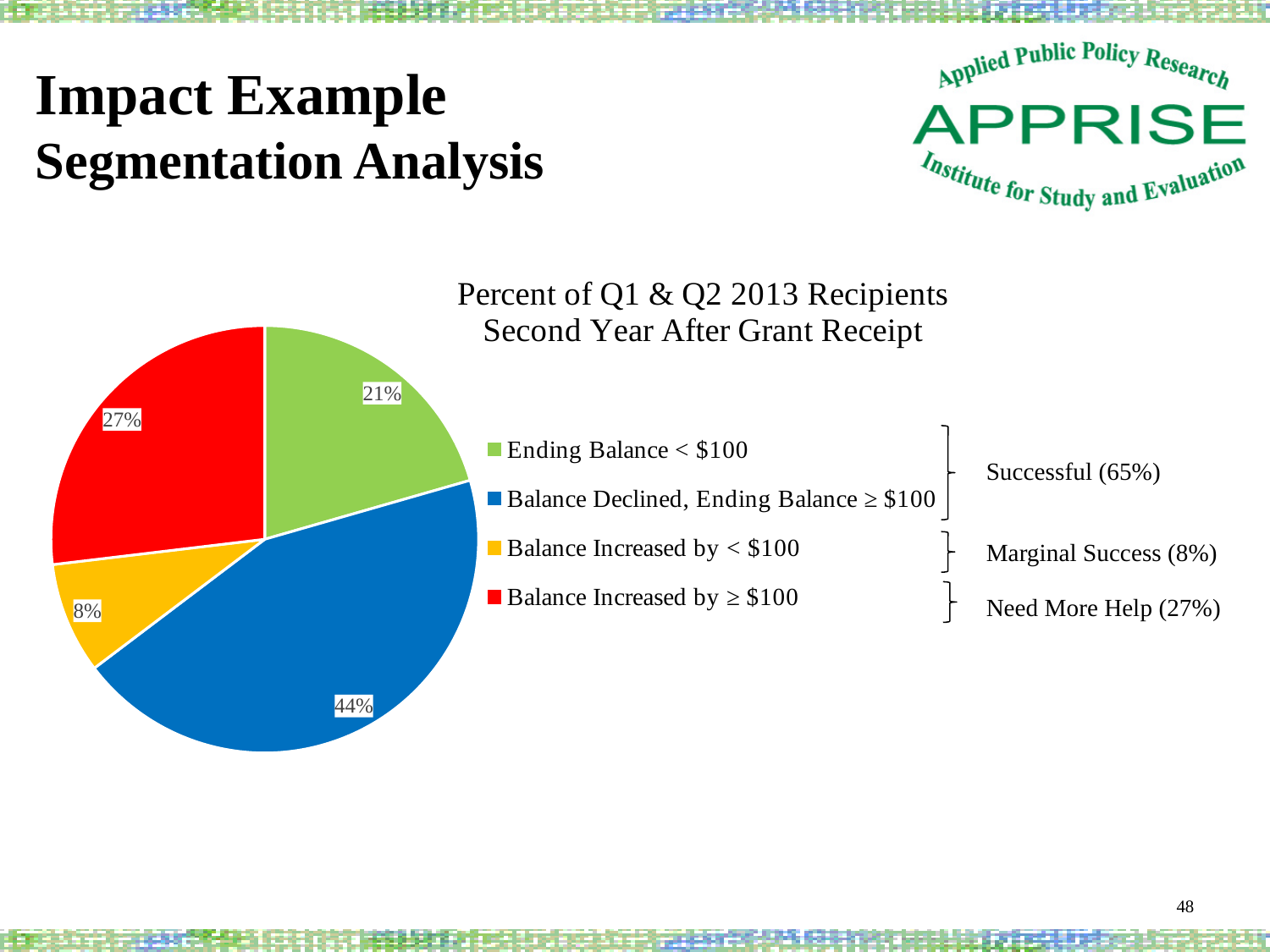
What kind of chart is shown on the slide? pie chart Which is larger: the share for Ending Balance < $100 or the share for Balance Increased by ≥ $100? Balance Increased by ≥ $100 What percentage of recipients had Balance Increased by < $100? 8% Which category has the smallest share of the pie? Balance Increased by < $100 What percentage of recipients had an Ending Balance < $100? 21% What percentage of recipients had Balance Declined, Ending Balance ≥ $100? 44% What is the title of the pie chart? Percent of Q1 & Q2 2013 Recipients Second Year After Grant Receipt What percentage of recipients had Balance Increased by ≥ $100? 27% What colour is the slice for Balance Increased by ≥ $100? red Which category has the largest share of the pie? Balance Declined, Ending Balance ≥ $100 What is the difference between the share for Balance Declined, Ending Balance ≥ $100 and the share for Balance Increased by ≥ $100? 17% How many slices does the pie chart have? 4